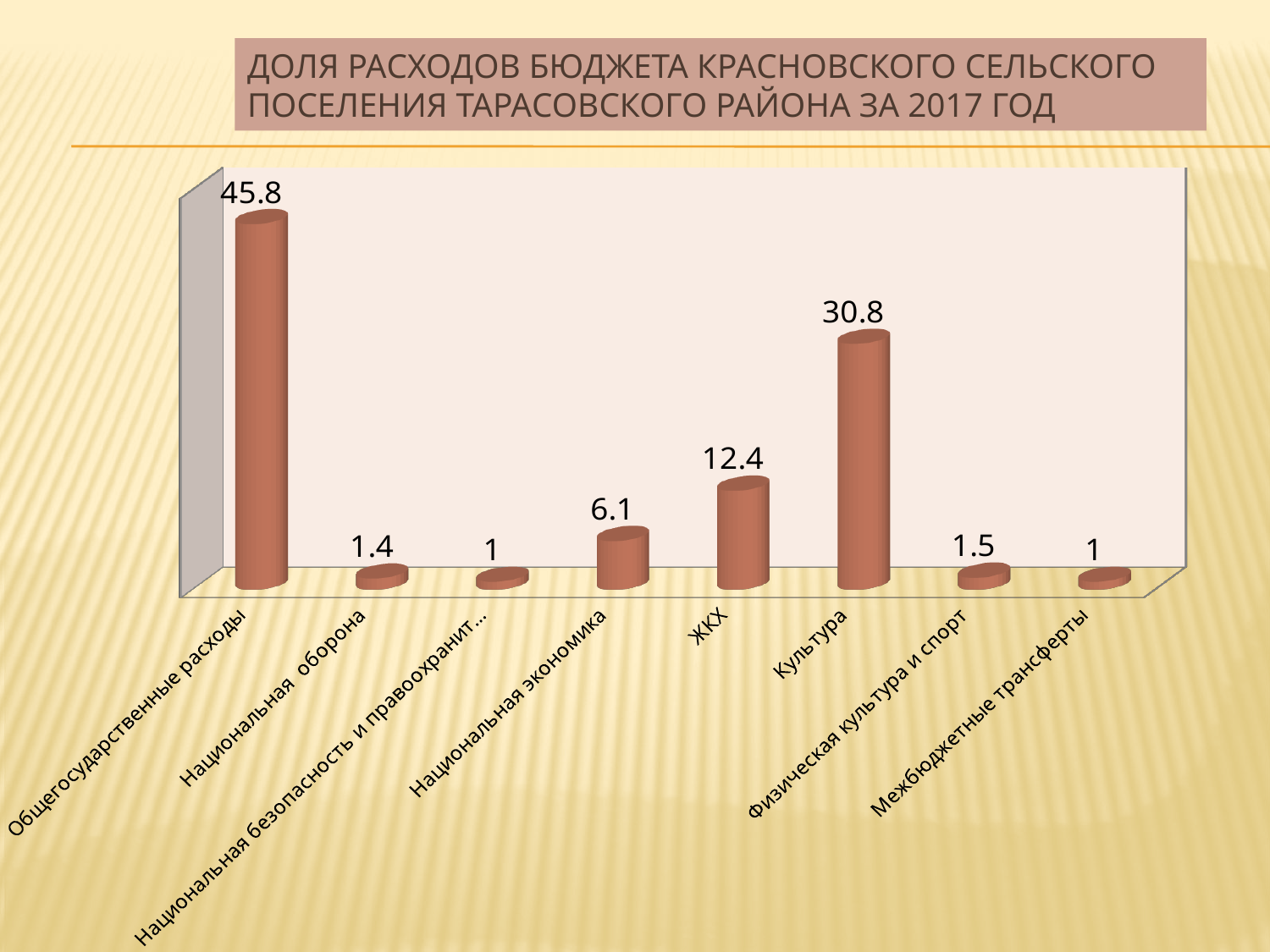
What year does the chart title say the budget expenditure shares are for? 2017 What is the value for ЖКХ? 12.4 What is the value for Межбюджетные трансферты? 1 How many categories are shown in the chart? 8 Which category has the highest value? Общегосударственные расходы What is the difference between the values for ЖКХ and Национальная экономика? 6.3 What kind of chart is shown on the slide? Bar chart What is the value for Национальная экономика? 6.1 Which is larger, the value for Национальная оборона or the value for Физическая культура и спорт? Физическая культура и спорт What is the difference between the values for Общегосударственные расходы and Культура? 15 What is the value for Культура? 30.8 What is the value for Физическая культура и спорт? 1.5